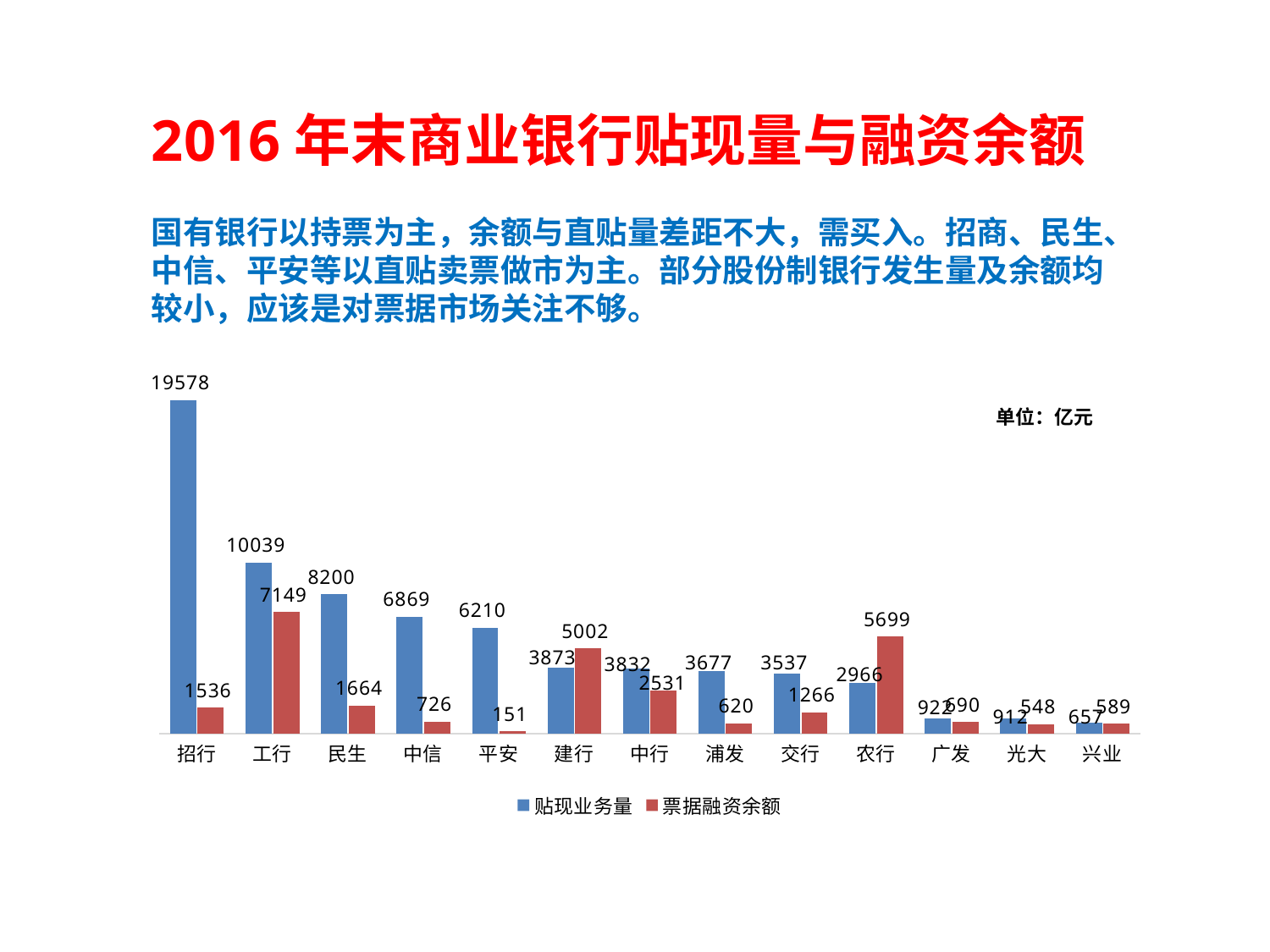
What is the difference between the 贴现业务量 and 票据融资余额 for 农行? 2733 Which bank has a higher 票据融资余额, 中行 or 交行? 中行 Which bank has the highest 贴现业务量? 招行 For 建行, which is larger: 贴现业务量 or 票据融资余额? 票据融资余额 What is the 票据融资余额 value for 平安? 151 How many series does the legend list? 2 Which bank has the lowest 票据融资余额? 平安 What unit is stated for the chart values? 亿元 What is the 贴现业务量 value for 招行? 19578 How many banks are shown on the x axis? 13 What kind of chart is shown on the slide? Bar chart What is the 票据融资余额 value for 工行? 7149